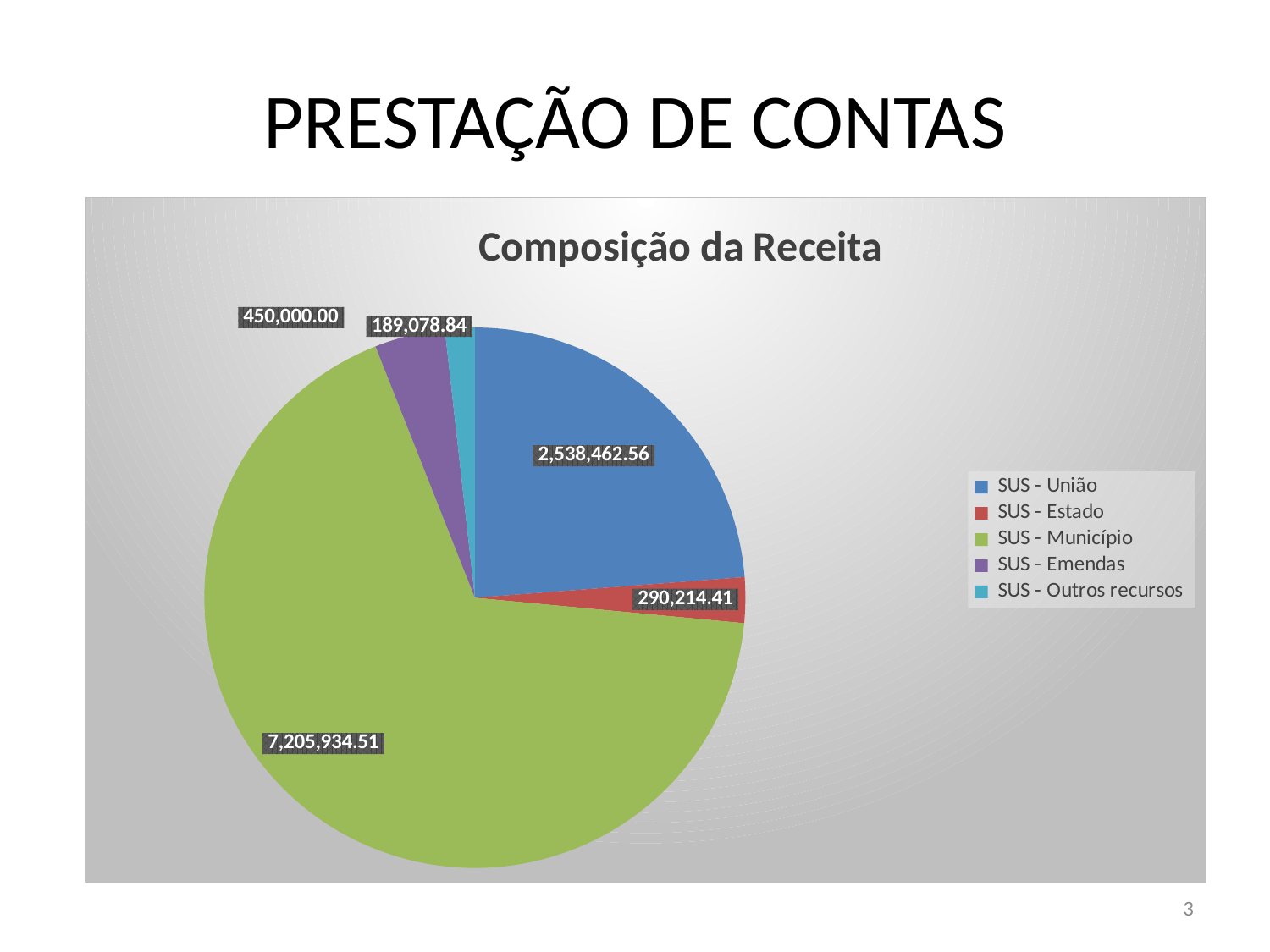
What is the difference between the values for SUS - Emendas and SUS - Outros recursos? 260,921.16 What is the value for SUS - União in the pie chart? 2,538,462.56 What is the value for SUS - Outros recursos in the pie chart? 189,078.84 What is the value for SUS - Emendas in the pie chart? 450,000.00 Which category has the smallest slice in the pie chart? SUS - Outros recursos What type of chart is shown on the slide? Pie chart Which is larger, the value for SUS - Emendas or the value for SUS - Estado? SUS - Emendas What is the difference between the values for SUS - União and SUS - Estado? 2,248,248.15 What is the value for SUS - Estado in the pie chart? 290,214.41 Which category has the largest slice in the Composição da Receita pie chart? SUS - Município How many categories does the legend of the pie chart list? 5 What is the value for SUS - Município in the Composição da Receita pie chart? 7,205,934.51